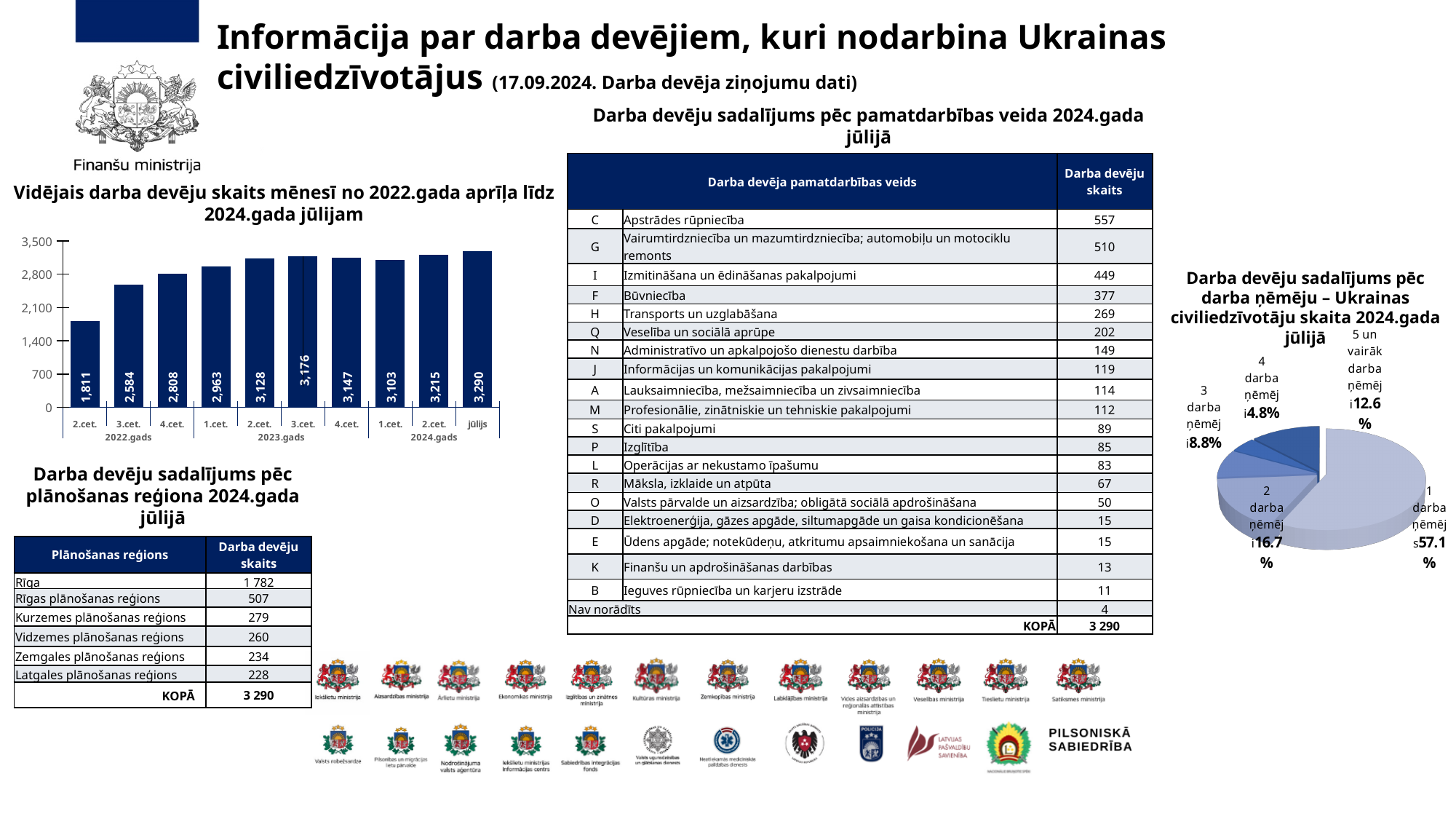
In the bar chart 'Vidējais darba devēju skaits mēnesī', which period has the highest value? jūlijs 2024.gads In the pie chart 'Darba devēju sadalījums pēc darba ņēmēju skaita', which category has the smallest share? 4 darba ņēmēji In the bar chart 'Vidējais darba devēju skaits mēnesī no 2022.gada aprīļa līdz 2024.gada jūlijam', what is the value for 2.cet. 2022.gads? 1,811 In the bar chart 'Vidējais darba devēju skaits mēnesī', which period has the lowest value? 2.cet. 2022.gads In the bar chart 'Vidējais darba devēju skaits mēnesī', what is the value for jūlijs 2024.gads? 3,290 In the pie chart 'Darba devēju sadalījums pēc darba ņēmēju – Ukrainas civiliedzīvotāju skaita 2024.gada jūlijā', what share do employers with 1 darba ņēmējs have? 57.1% In the bar chart 'Vidējais darba devēju skaits mēnesī', what is the difference between the values for 3.cet. 2022.gads and 2.cet. 2022.gads? 773 What type of chart is 'Vidējais darba devēju skaits mēnesī no 2022.gada aprīļa līdz 2024.gada jūlijam'? Bar chart In the bar chart 'Vidējais darba devēju skaits mēnesī', which is larger: the value for 2.cet. 2023.gads or 1.cet. 2024.gads? 2.cet. 2023.gads In the bar chart 'Vidējais darba devēju skaits mēnesī', what is the value for 3.cet. 2023.gads? 3,176 How many bars are shown in the bar chart 'Vidējais darba devēju skaits mēnesī'? 10 How many slices does the pie chart 'Darba devēju sadalījums pēc darba ņēmēju skaita' have? 5